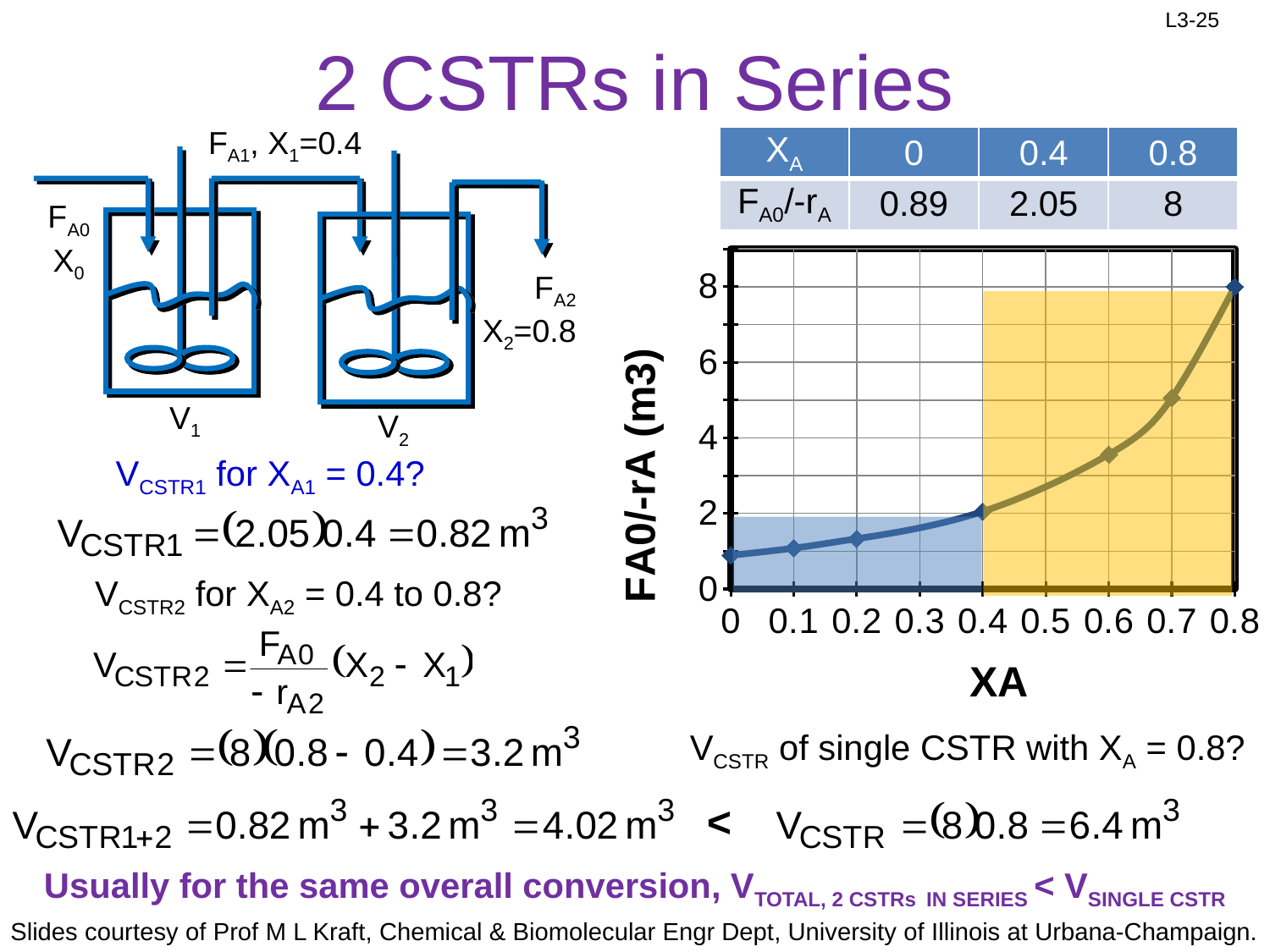
At which XA value is FA0/-rA highest? 0.8 What is the label of the vertical axis of the chart? FA0/-rA (m3) What is the value of FA0/-rA at XA = 0? 0.89 What kind of chart is shown on the slide? line chart Is the value of FA0/-rA at XA = 0.6 greater or less than 4? less What is the difference between FA0/-rA at XA = 0.4 and at XA = 0? 1.16 Is the value of FA0/-rA at XA = 0.7 greater or less than 4? greater At which XA value is FA0/-rA lowest? 0 What is the difference between FA0/-rA at XA = 0.8 and at XA = 0.4? 5.95 What is the value of FA0/-rA at XA = 0.4? 2.05 What is the value of FA0/-rA at XA = 0.8? 8 Does FA0/-rA rise or fall as XA increases from 0 to 0.8? rise